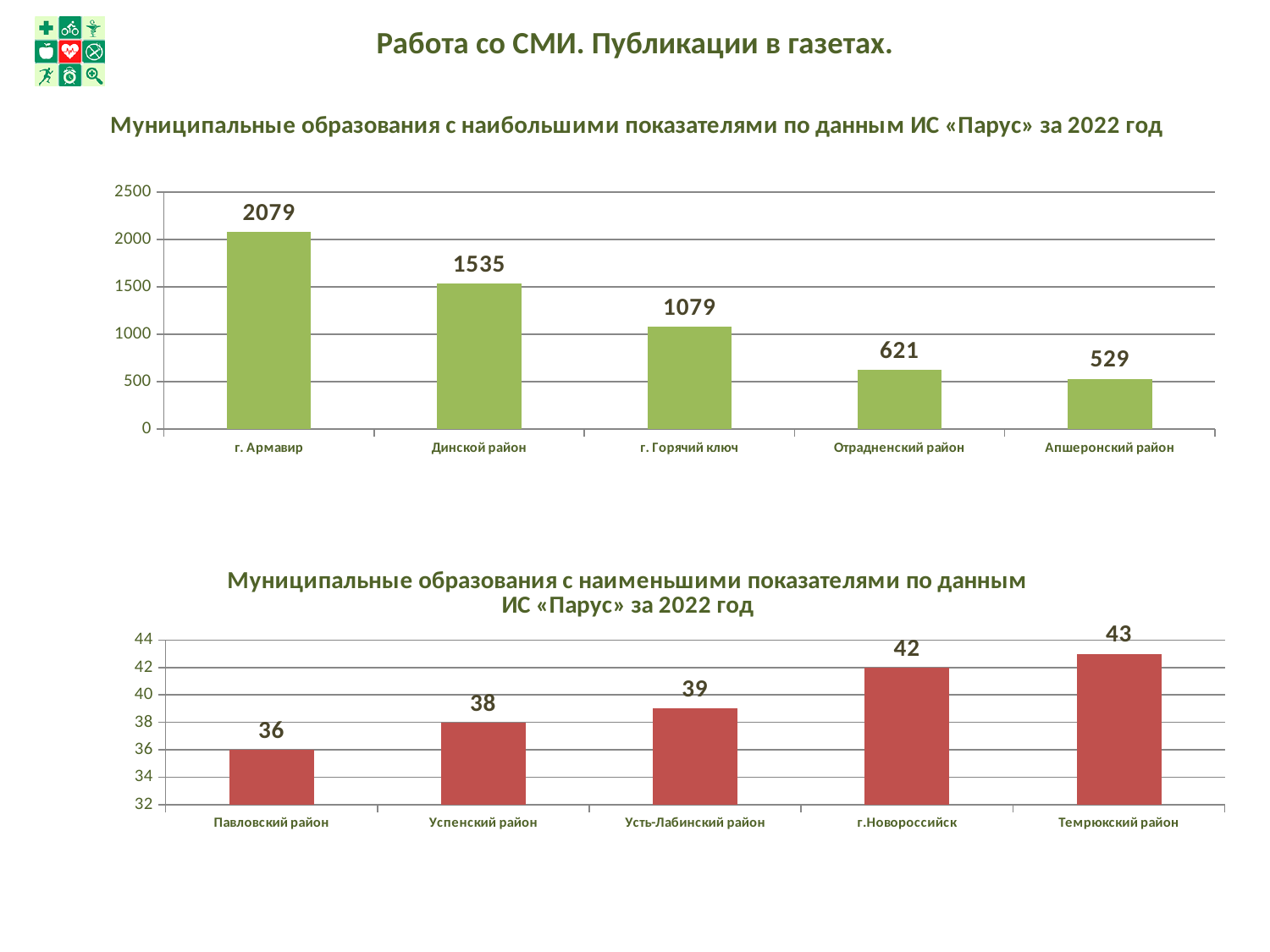
What kind of chart is the bottom chart (Муниципальные образования с наименьшими показателями)? bar chart In the top chart (Муниципальные образования с наибольшими показателями), how many categories are shown? 5 In the bottom chart (Муниципальные образования с наименьшими показателями), what is the difference between Темрюкский район and Павловский район? 7 In the bottom chart (Муниципальные образования с наименьшими показателями), which is larger: Успенский район or г.Новороссийск? г.Новороссийск In the bottom chart (Муниципальные образования с наименьшими показателями), which category has the highest value? Темрюкский район In the top chart (Муниципальные образования с наибольшими показателями), do the values rise or fall from left to right? fall What colour are the bars in the top chart (Муниципальные образования с наибольшими показателями)? green In the top chart (Муниципальные образования с наибольшими показателями), what is the difference between г. Армавир and Динской район? 544 In the top chart (Муниципальные образования с наибольшими показателями), what is the value for Отрадненский район? 621 In the top chart (Муниципальные образования с наибольшими показателями), which category has the lowest value? Апшеронский район In the bottom chart (Муниципальные образования с наименьшими показателями), what is the value for Усть-Лабинский район? 39 In the top chart (Муниципальные образования с наибольшими показателями), what is the value for г. Армавир? 2079